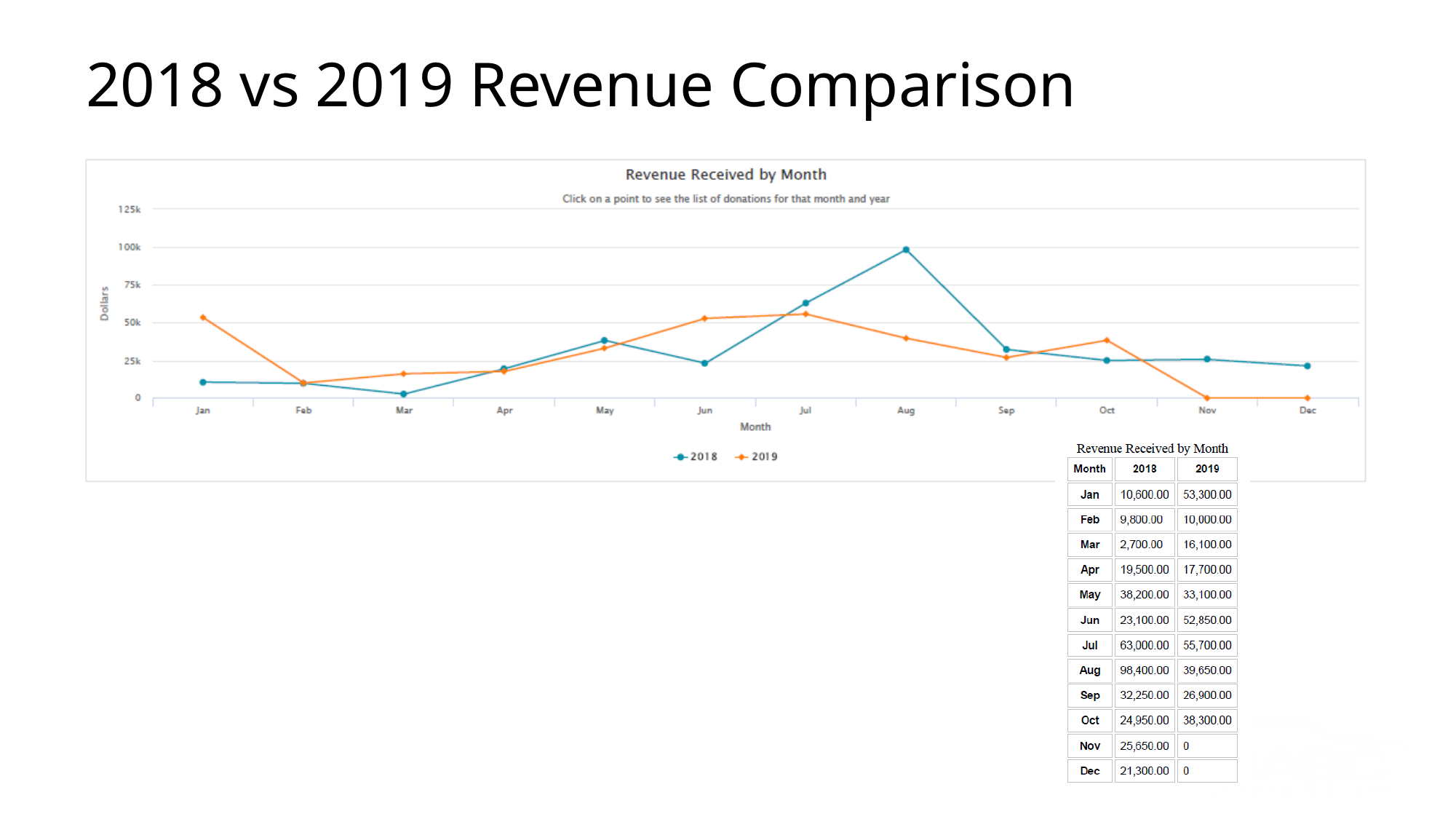
How many series does the chart legend list? 2 How many months are plotted along the x axis of the chart? 12 Does the 2019 line rise or fall from Aug to Nov? fall What is the 2019 revenue for Jan? 53,300.00 What is the 2018 revenue for Aug? 98,400.00 What is the title of the chart? Revenue Received by Month Is the 2018 value for Aug greater or less than 75k? greater What is the difference between the 2018 and 2019 revenue for Jul? 7,300.00 Which month has the lowest 2018 revenue? Mar Which series has the larger value in Jun, 2018 or 2019? 2019 What type of chart is shown on the slide? line chart Which month has the highest 2018 revenue? Aug